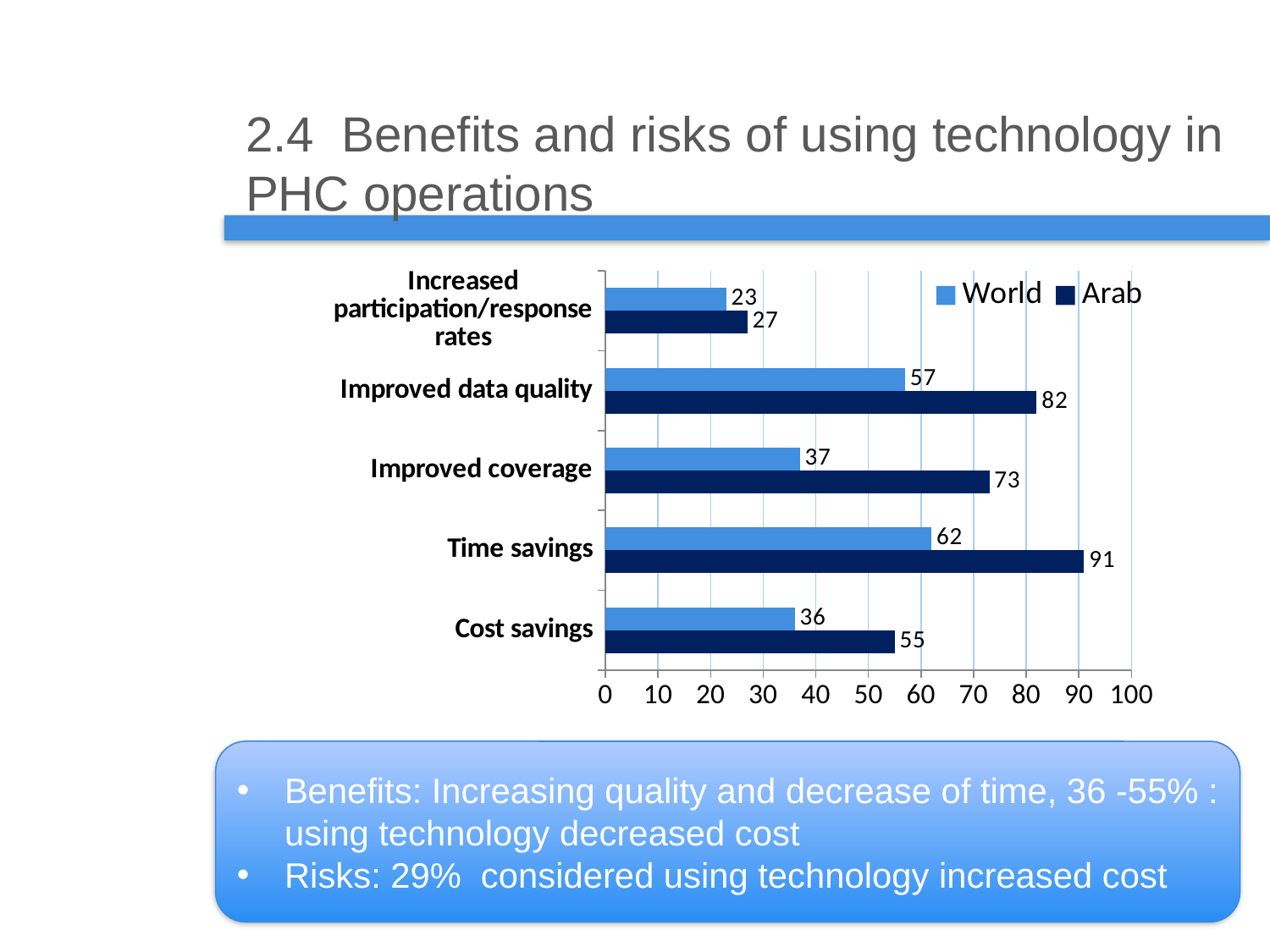
Which category has the highest Arab value? Time savings What is the World value for Cost savings? 36 How many categories are shown on the chart? 5 Which is larger for Improved data quality, the World value or the Arab value? Arab What is the difference between the Arab and World values for Improved coverage? 36 What is the World value for Improved data quality? 57 Is the Arab value for Cost savings greater or less than 50? greater Which series is shown in the darker blue colour? Arab Which category has the lowest World value? Increased participation/response rates What is the Arab value for Time savings? 91 What kind of chart is shown on the slide? Bar chart How many series does the legend list? 2